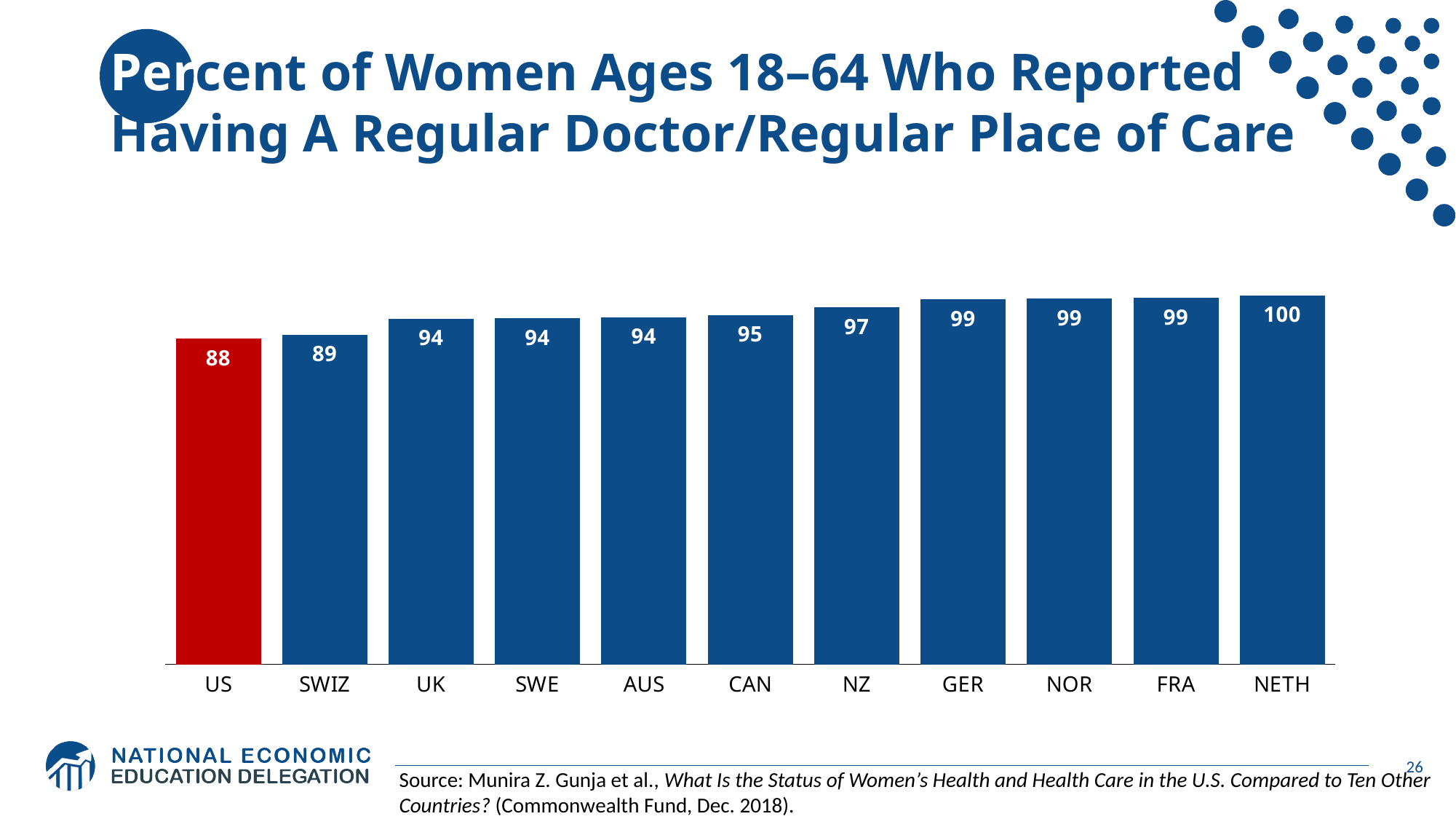
What is the value for the US? 88 How many countries are shown in the chart? 11 What is the difference between the values for SWIZ and UK? 5 What is the difference between the values for NETH and the US? 12 What is the value for CAN? 95 What kind of chart is shown on the slide? bar chart Which country has the highest value? NETH What is the value for NZ? 97 Which country has the lowest value? US Do the values rise or fall from left to right across the chart? rise Which bar is coloured red rather than blue? US Which has a larger value, SWIZ or CAN? CAN